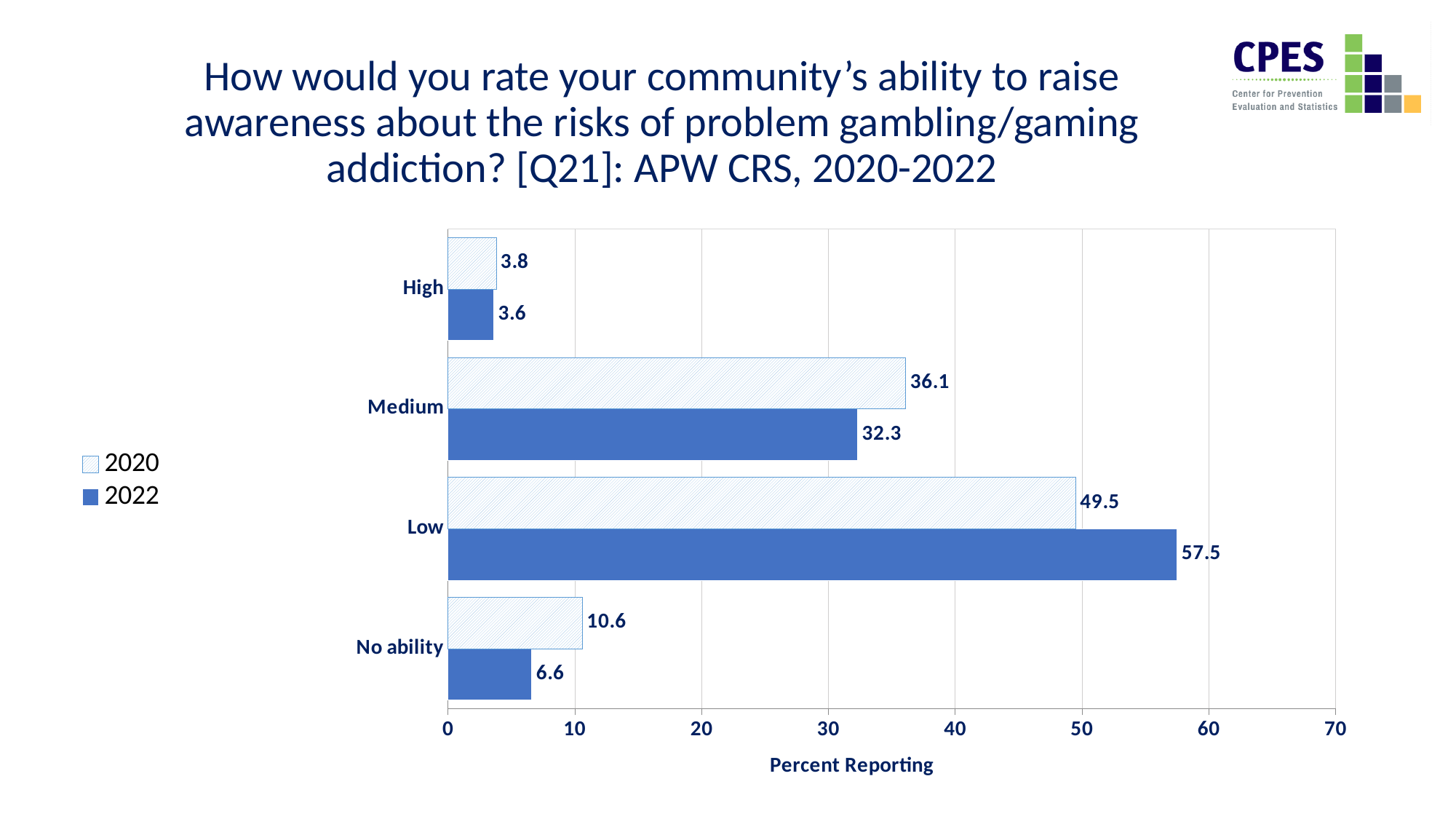
How many series does the legend list? 2 What is the 2020 value for No ability? 10.6 What is the difference between the 2020 and 2022 values for No ability? 4.0 Which category has the highest 2022 value? Low What is the difference between the 2022 and 2020 values for Low? 8.0 What is the label of the x axis? Percent Reporting What kind of chart is shown? bar chart Which is larger for Medium, the 2020 value or the 2022 value? 2020 How many categories are shown on the y axis? 4 What is the 2022 value for Low? 57.5 Which category has the lowest 2020 value? High What is the 2020 value for Medium? 36.1